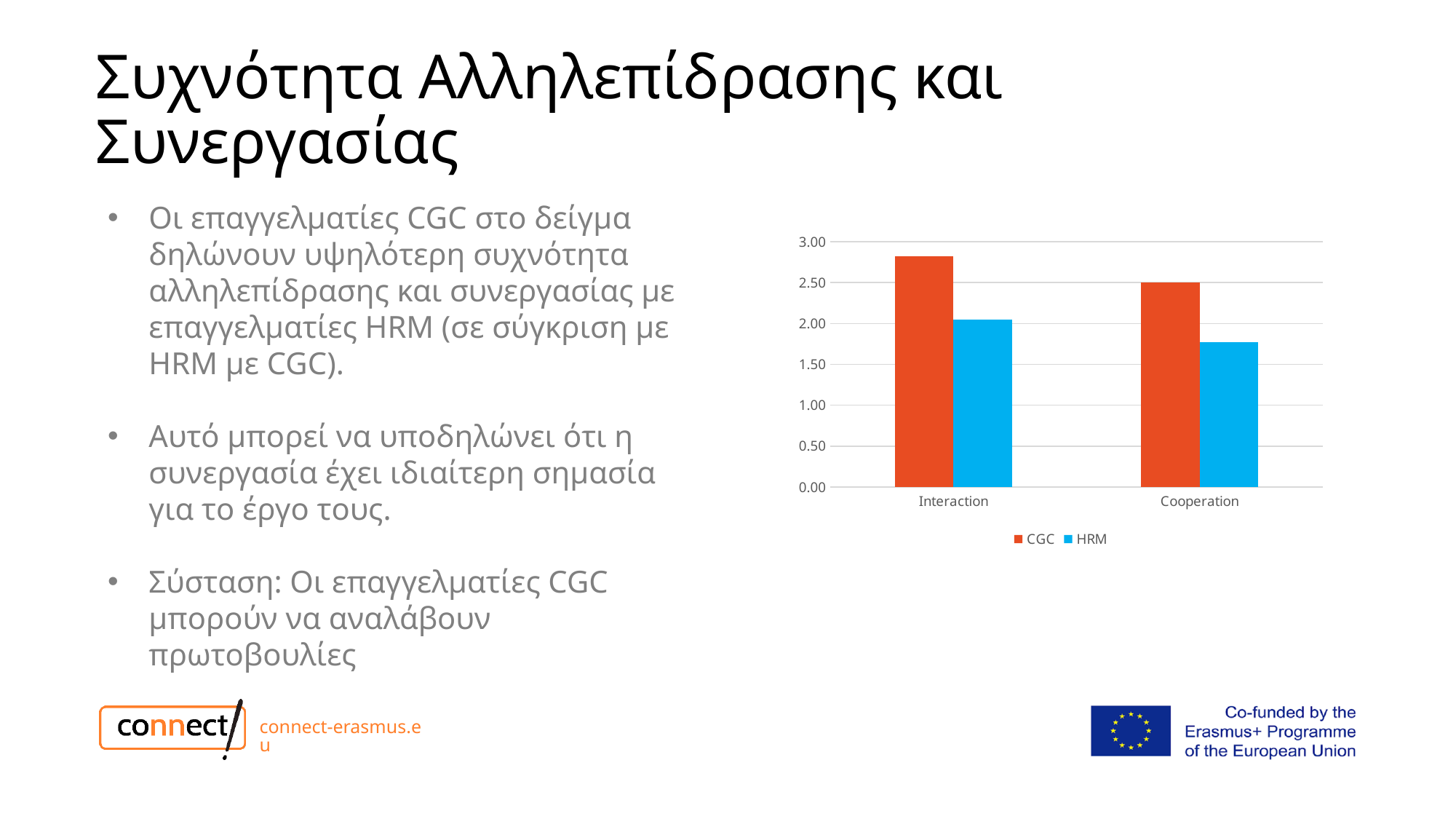
What kind of chart is shown on the slide? bar chart How many series does the chart legend list? 2 Which series has the higher value for Cooperation, CGC or HRM? CGC Which series has the higher value for Interaction, CGC or HRM? CGC How many categories are shown on the x axis of the chart? 2 Which bar in the chart is the tallest? CGC for Interaction Does the CGC value rise or fall from Interaction to Cooperation? fall Is the HRM value for Cooperation greater or less than 2.00? less Which bar in the chart is the shortest? HRM for Cooperation Is the CGC value for Cooperation greater or less than 2.00? greater Is the CGC value for Interaction greater or less than 2.50? greater What colour are the HRM bars in the chart? blue